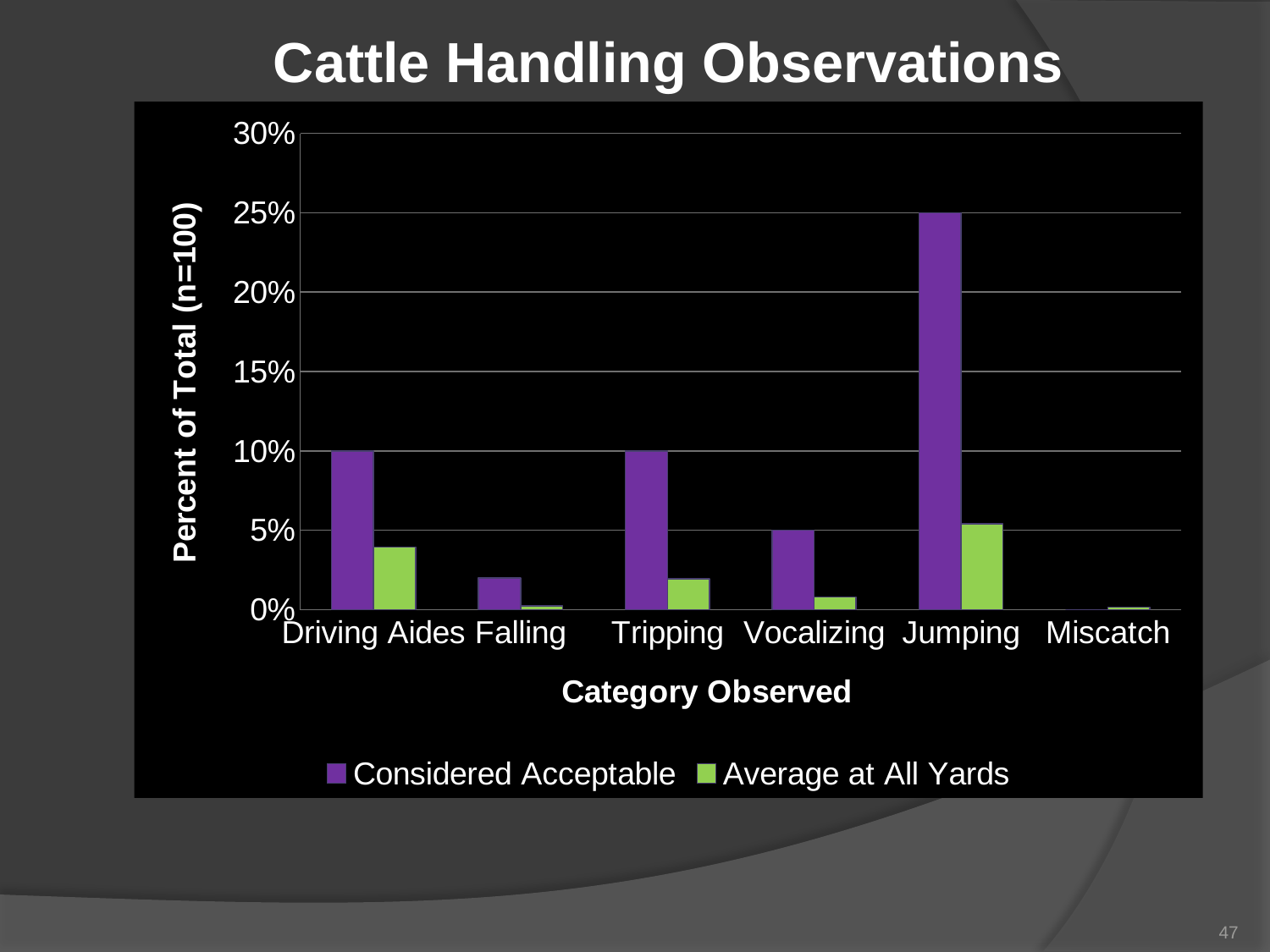
How many series does the legend list? 2 What is the Considered Acceptable value for Jumping? 25% What kind of chart is shown on the slide? bar chart Is the Average at All Yards value for Driving Aides greater or less than 5%? less What is the difference between the Considered Acceptable values for Jumping and Driving Aides? 15% What is the Considered Acceptable value for Vocalizing? 5% Which category has the lowest Considered Acceptable value? Miscatch Which category has the highest Considered Acceptable value? Jumping What is the Considered Acceptable value for Driving Aides? 10% What is the title of the y axis? Percent of Total (n=100) How many categories are shown on the x axis? 6 Which is larger, the Considered Acceptable value for Driving Aides or for Falling? Driving Aides